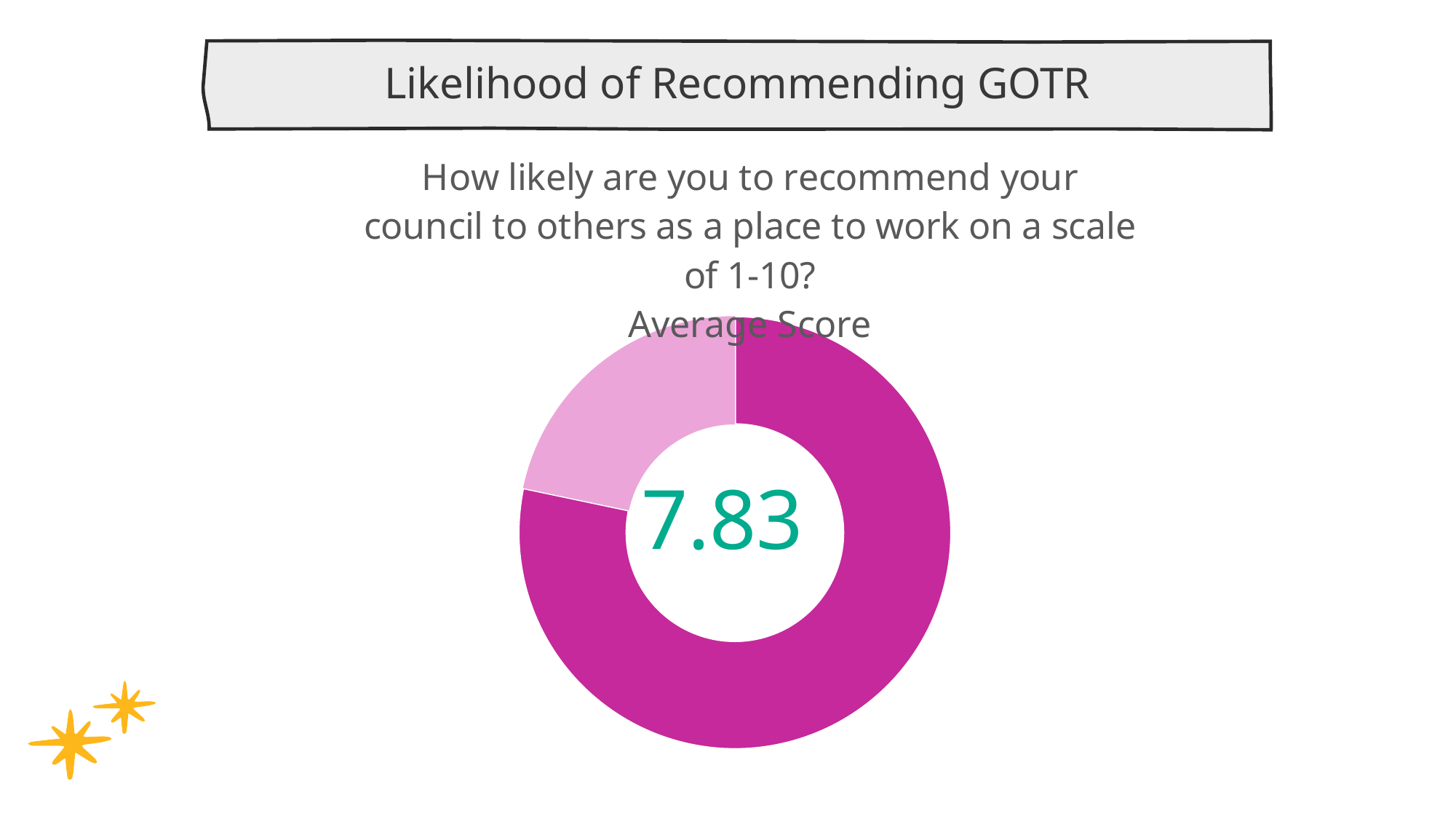
What average score is displayed in the centre of the donut chart? 7.83 On what scale was the recommendation question asked, according to the slide? 1-10 Is the average score shown in the donut chart greater or less than 10? less Is the average score shown in the donut chart greater or less than 5? greater What kind of chart is shown on the slide? Donut (pie) chart How many slices does the donut chart have? 2 What is the title shown in the banner at the top of the slide? Likelihood of Recommending GOTR What is the title of the chart on the slide? How likely are you to recommend your council to others as a place to work on a scale of 1-10? Average Score Which slice of the donut chart is larger, the dark magenta slice or the light pink slice? The dark magenta slice